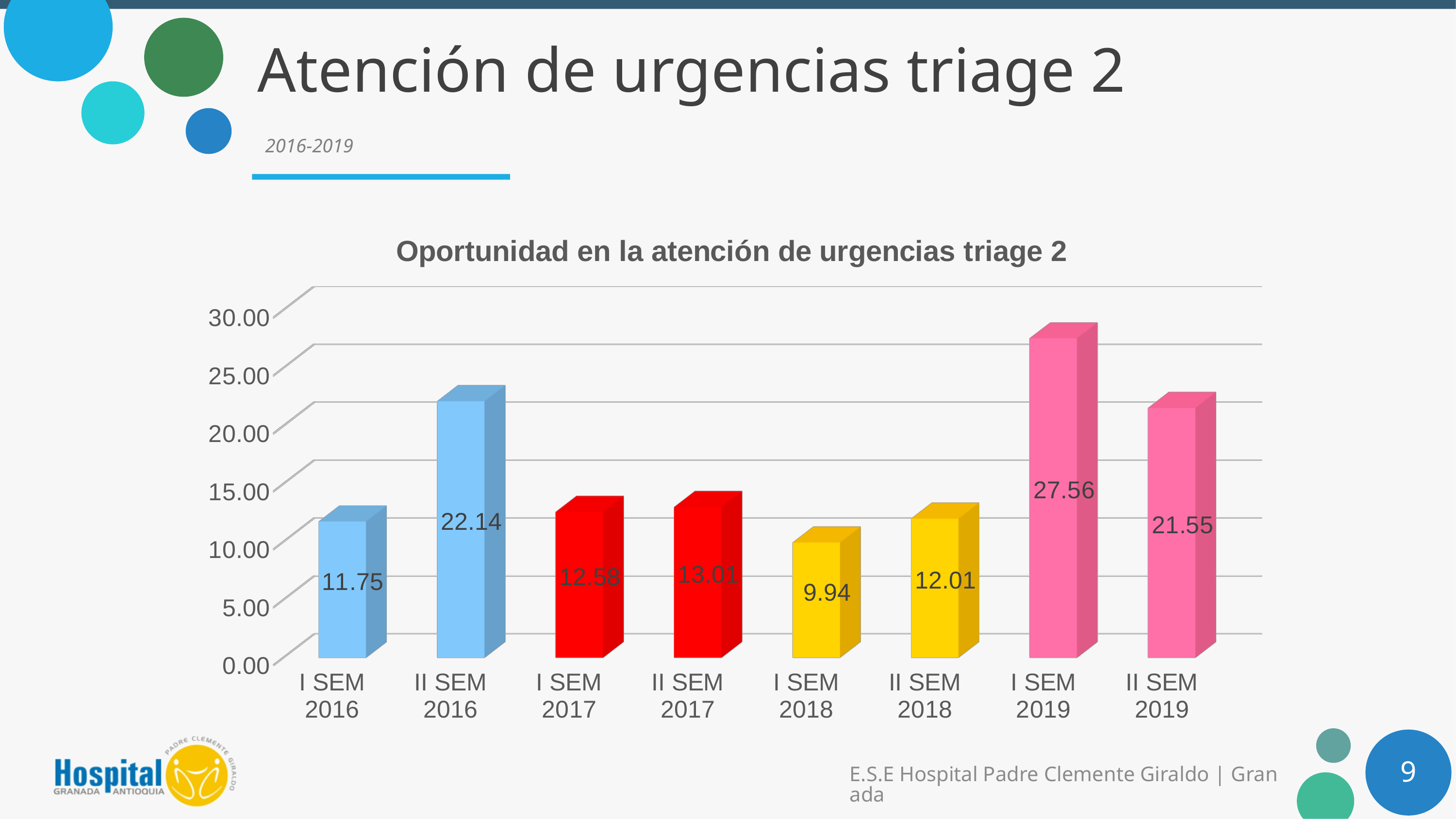
What is the difference between the values for I SEM 2019 and II SEM 2019? 6.01 What is the value for I SEM 2019? 27.56 What kind of chart is shown on the slide? bar chart Which is larger, the value for I SEM 2017 or II SEM 2017? II SEM 2017 What is the value for II SEM 2018? 12.01 What is the title of the chart? Oportunidad en la atención de urgencias triage 2 What is the value for I SEM 2016? 11.75 Which category has the highest value? I SEM 2019 How many categories are shown on the x axis? 8 Which category has the lowest value? I SEM 2018 What is the value for II SEM 2016? 22.14 Is the value for II SEM 2016 greater or less than 20.00? greater